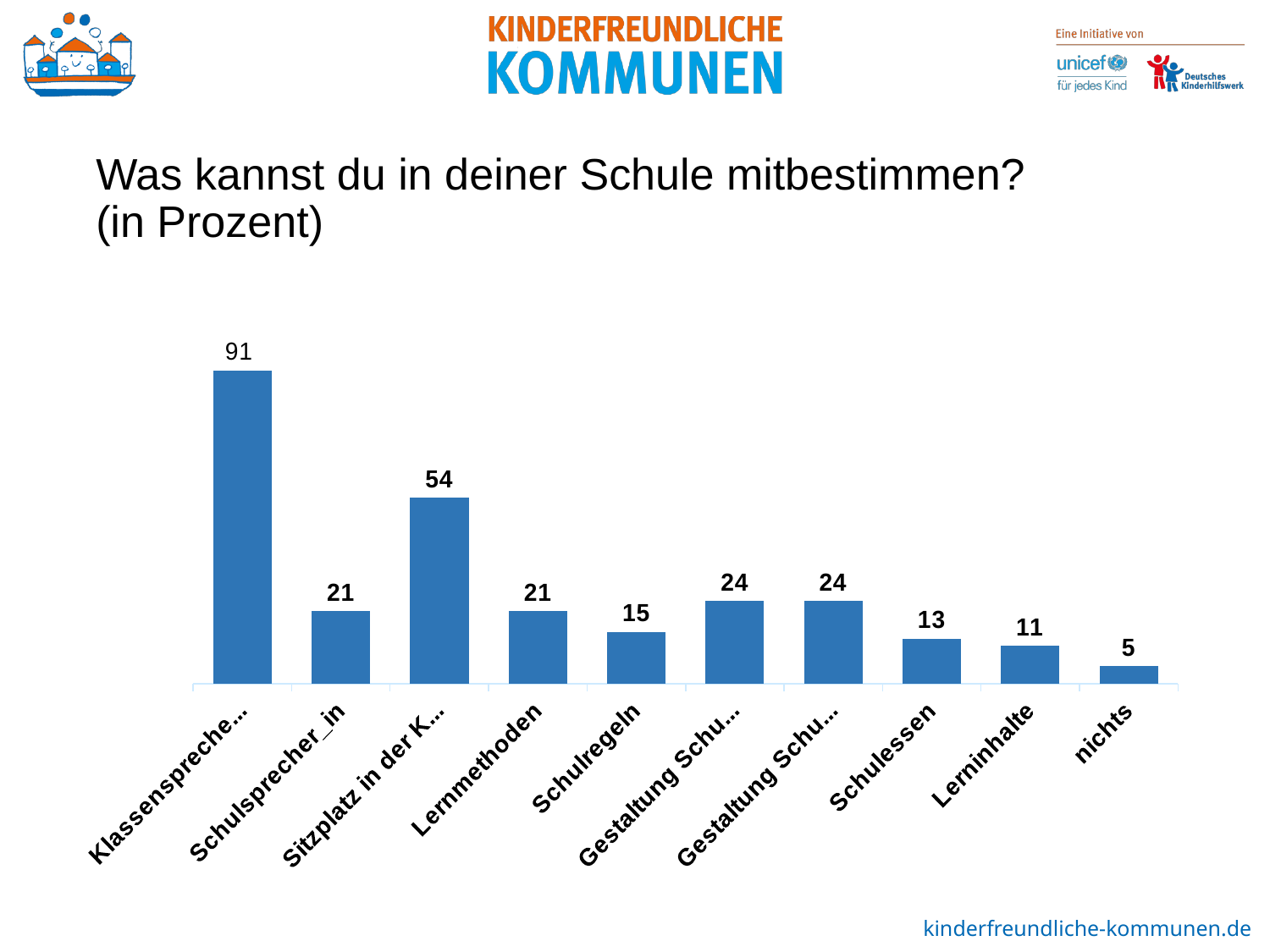
What is the difference between the values for Schulessen and nichts? 8 What value is shown for Schulregeln? 15 What value is shown for Lernmethoden? 21 How many categories are shown in the chart? 10 What is the highest value shown in the chart? 91 What is the difference between the values for Schulsprecher_in and Schulregeln? 6 What value is shown for Schulessen? 13 What kind of chart is shown on the slide? bar chart Which is larger, the value for Schulessen or the value for Lerninhalte? Schulessen Which category has the lowest value? nichts What is the title of the chart on the slide? Was kannst du in deiner Schule mitbestimmen? (in Prozent) What value is shown for Lerninhalte? 11